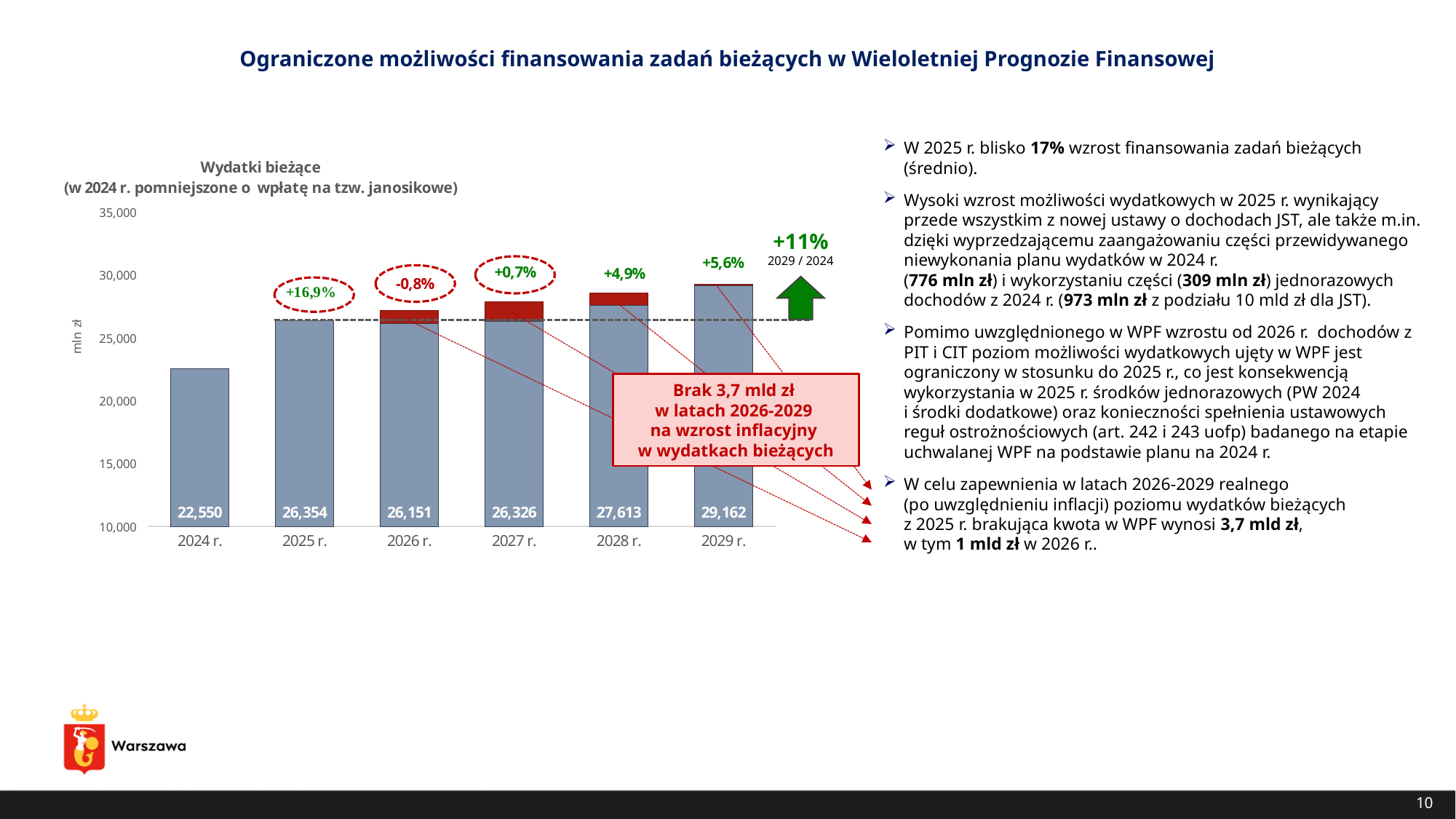
What unit is shown on the y axis of the Wydatki bieżące chart? mln zł What is the value for 2024 r. in the Wydatki bieżące chart? 22,550 Is the value for 2028 r. in the Wydatki bieżące chart greater or less than 25,000? greater What percentage change is labelled above the 2025 r. bar in the Wydatki bieżące chart? +16,9% What kind of chart is the Wydatki bieżące chart? bar chart What is the difference between the values for 2029 r. and 2024 r. in the Wydatki bieżące chart? 6,612 Which year has the lowest value in the Wydatki bieżące chart? 2024 r. What is the value for 2029 r. in the Wydatki bieżące chart? 29,162 How many years are shown on the x axis of the Wydatki bieżące chart? 6 What is the value for 2026 r. in the Wydatki bieżące chart? 26,151 Which is larger in the Wydatki bieżące chart, the value for 2025 r. or the value for 2026 r.? 2025 r. Which year has the highest value in the Wydatki bieżące chart? 2029 r.